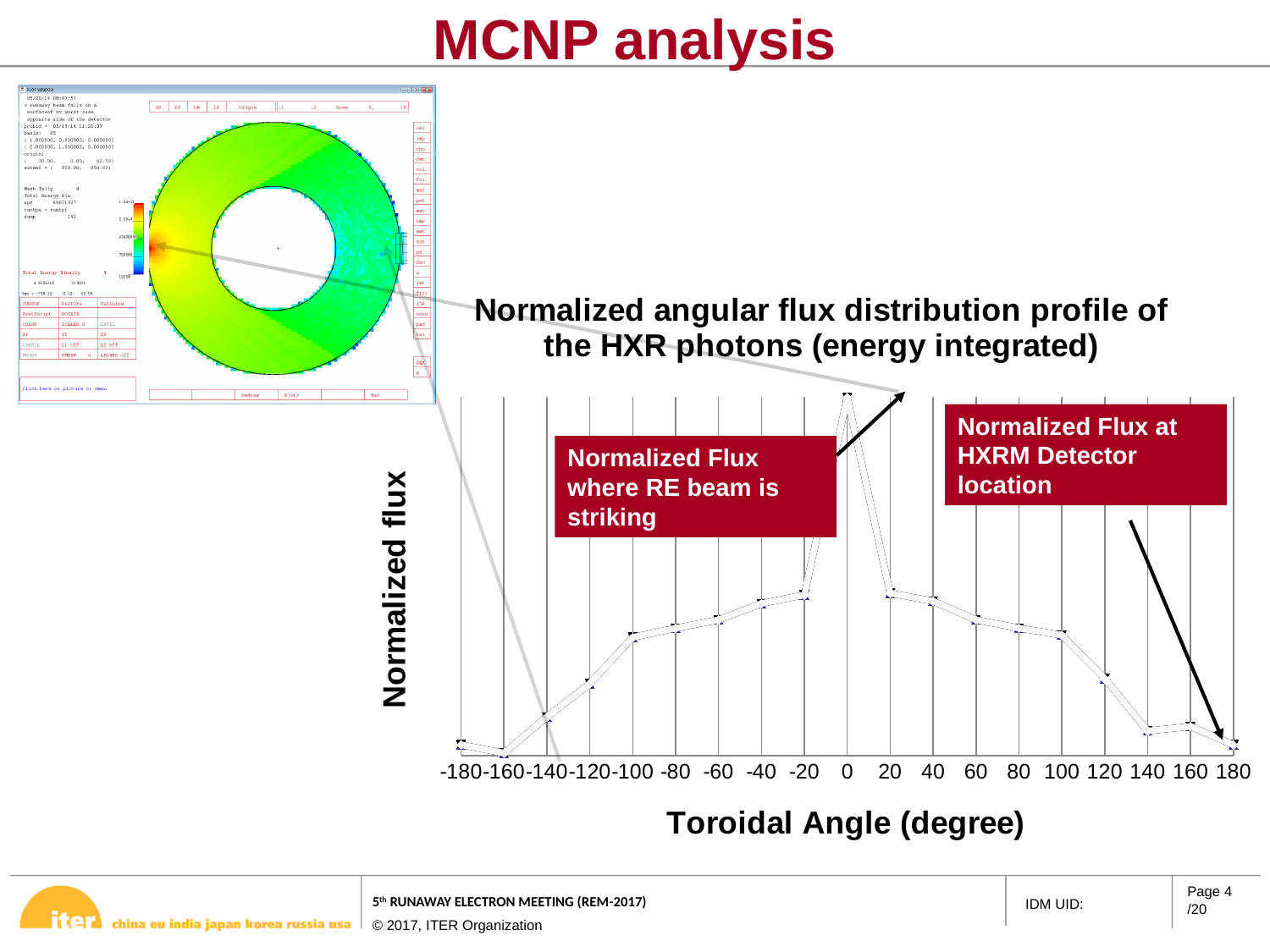
How does the normalized flux change as the toroidal angle increases from -180 to 0 degrees? rises Which has the larger normalized flux: a toroidal angle of 60 degrees or 160 degrees? 60 degrees How many tick labels are shown on the x axis of the line chart? 19 How does the normalized flux change as the toroidal angle increases from 0 to 180 degrees? falls What is the title of the x axis of the line chart? Toroidal Angle (degree) What is the title of the y axis of the line chart? Normalized flux Which has the larger normalized flux: a toroidal angle of -20 degrees or 140 degrees? -20 degrees What is the highest toroidal angle labelled on the x axis of the line chart? 180 At which toroidal angle does the normalized flux reach its highest value? 0 What kind of chart is shown at the bottom right of the slide? line chart Which has the larger normalized flux: a toroidal angle of -100 degrees or 0 degrees? 0 degrees What is the lowest toroidal angle labelled on the x axis of the line chart? -180